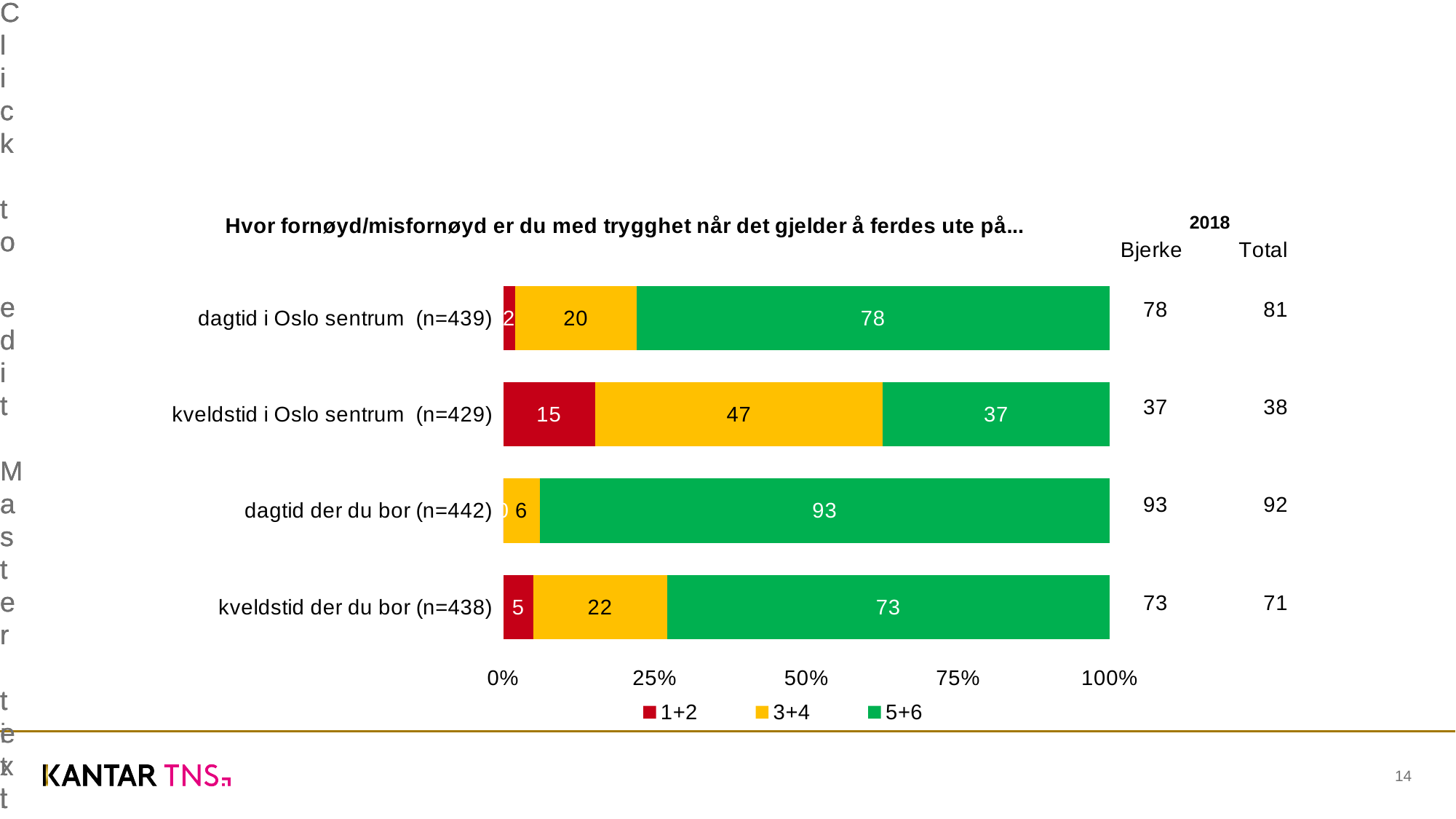
What is the value of the 3+4 series for 'kveldstid i Oslo sentrum (n=429)'? 47 How many series does the legend list? 3 Which category has the highest value for the 5+6 series? dagtid der du bor (n=442) Which is larger: the 3+4 value for 'kveldstid der du bor (n=438)' or the 3+4 value for 'dagtid i Oslo sentrum (n=439)'? kveldstid der du bor (n=438) Which series in the legend is shown in green? 5+6 What kind of chart is shown on the slide? Stacked bar chart What is the value of the 5+6 series for 'dagtid der du bor (n=442)'? 93 What is the difference between the 5+6 values for 'dagtid i Oslo sentrum (n=439)' and 'kveldstid i Oslo sentrum (n=429)'? 41 How many categories are plotted in the chart? 4 What is the value of the 5+6 series for 'dagtid i Oslo sentrum (n=439)'? 78 What is the value of the 1+2 series for 'kveldstid der du bor (n=438)'? 5 Which category has the lowest value for the 5+6 series? kveldstid i Oslo sentrum (n=429)